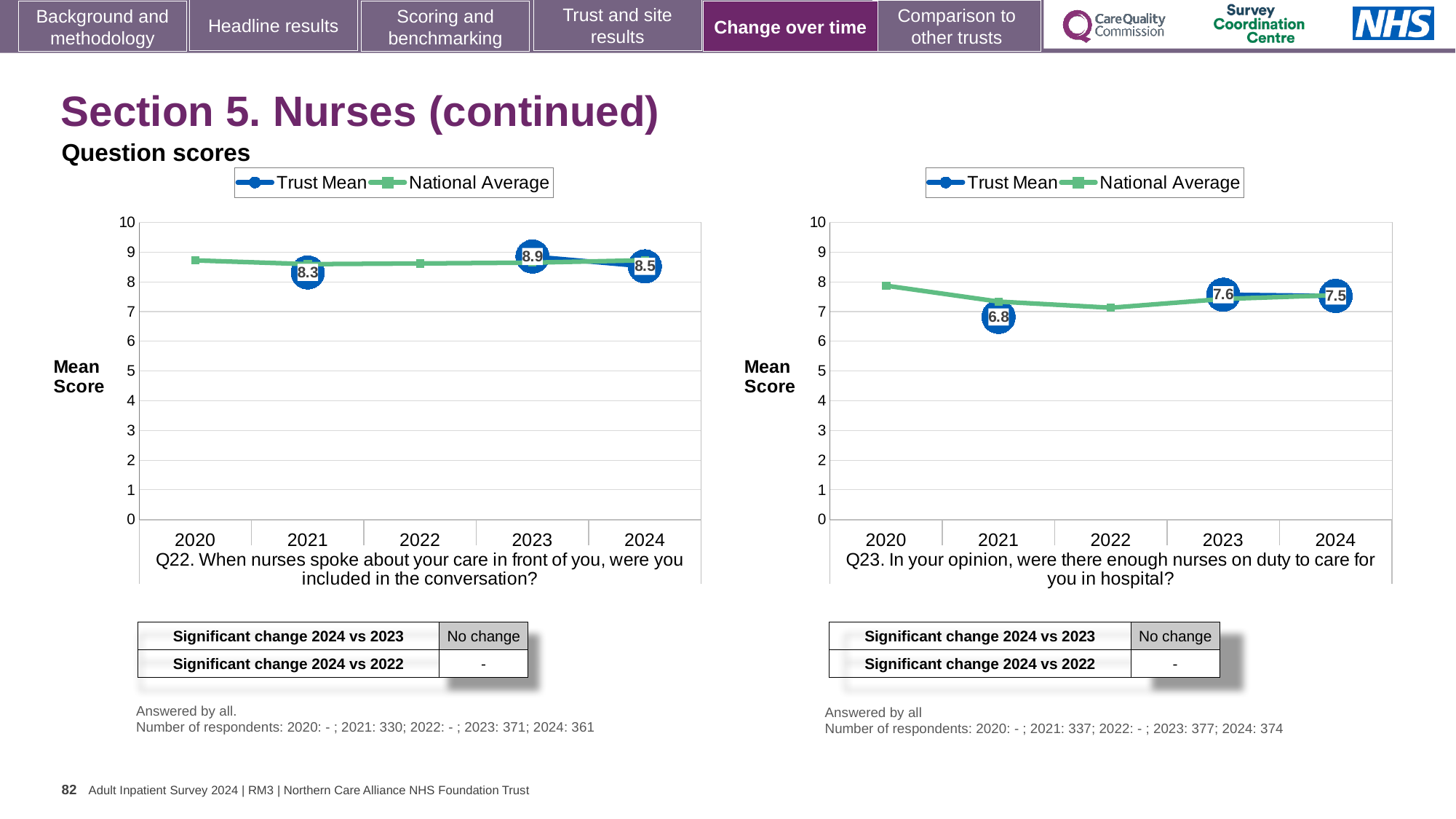
How many series does the legend list on the Q22 chart (left)? 2 On the Q22 chart (left), what is the Trust Mean score for 2023? 8.9 What kind of chart is the Q23 chart (right)? Line chart On the Q23 chart (right), is the Trust Mean score for 2021 greater or less than 7? less On the Q22 chart (left), which year has the highest labelled Trust Mean score? 2023 On the Q22 chart (left), what is the Trust Mean score for 2021? 8.3 On the Q23 chart (right), what is the Trust Mean score for 2021? 6.8 On the Q23 chart (right), what is the Trust Mean score for 2024? 7.5 On the Q23 chart (right), which year has the lowest labelled Trust Mean score? 2021 On the Q23 chart (right), what is the difference between the Trust Mean scores for 2023 and 2021? 0.8 On the Q23 chart (right), which series is shown in green? National Average On the Q22 chart (left), what is the difference between the Trust Mean scores for 2023 and 2024? 0.4